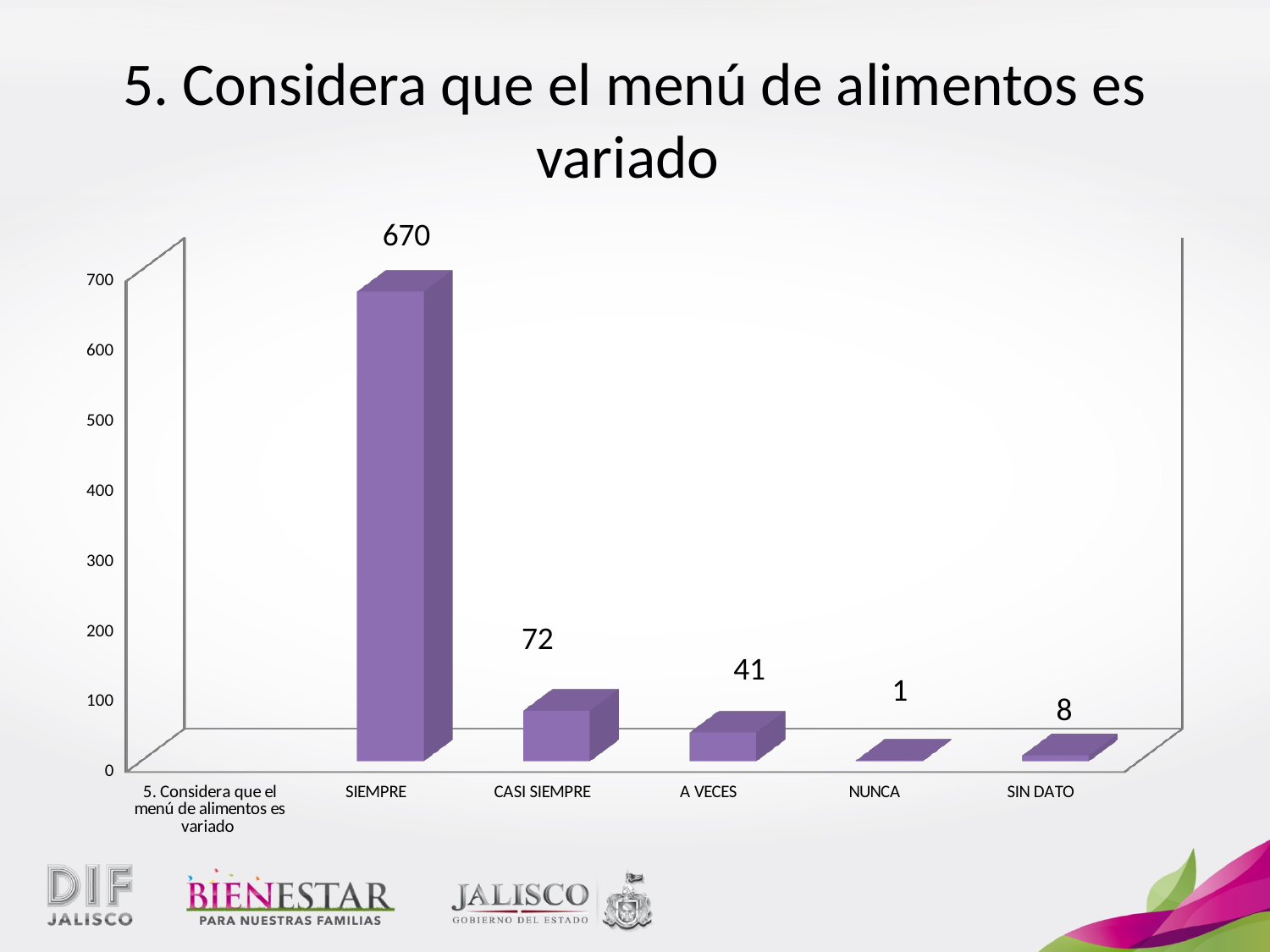
Which category has the highest value? SIEMPRE What is the value for SIEMPRE? 670 What is the value for NUNCA? 1 Which is larger, the value for A VECES or the value for SIN DATO? A VECES What is the value for A VECES? 41 Which category has the lowest value? NUNCA Is the value for CASI SIEMPRE greater or less than 100? less What is the difference between the values for SIEMPRE and CASI SIEMPRE? 598 What kind of chart is shown on the slide? bar chart What is the value for CASI SIEMPRE? 72 What is the value for SIN DATO? 8 How many bars are plotted in the chart? 5